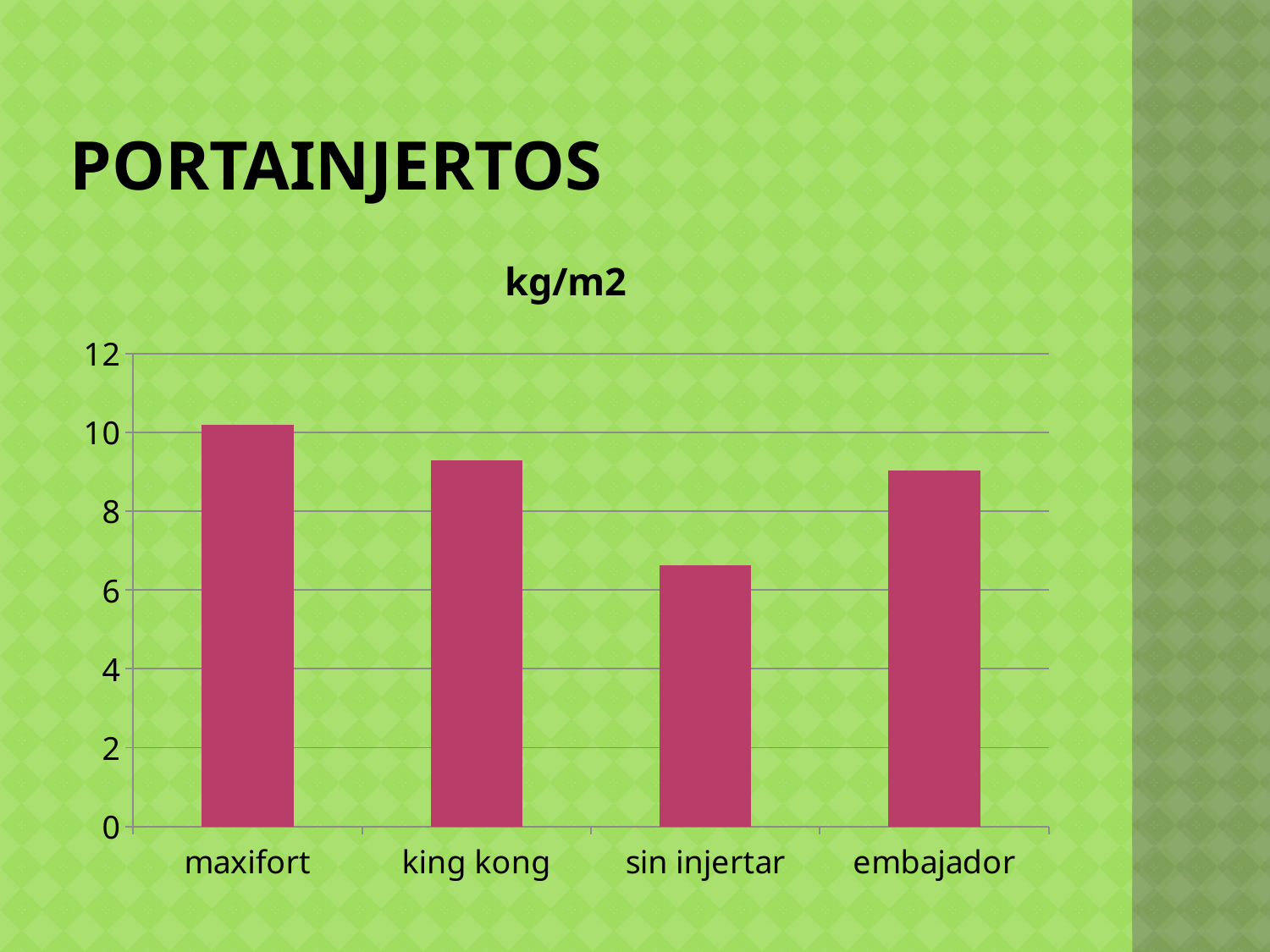
What kind of chart is shown on the slide? bar chart Is the value for king kong greater or less than 8? greater Which category has the lowest value in the chart? sin injertar Which is larger, the value for king kong or the value for embajador? king kong What is the title of the chart? kg/m2 Which is larger, the value for maxifort or the value for sin injertar? maxifort How many categories are shown on the x axis of the chart? 4 Is the value for sin injertar greater or less than 8? less What is the highest value shown on the vertical axis of the chart? 12 Which category has the highest value in the chart? maxifort Is the value for maxifort greater or less than 10? greater